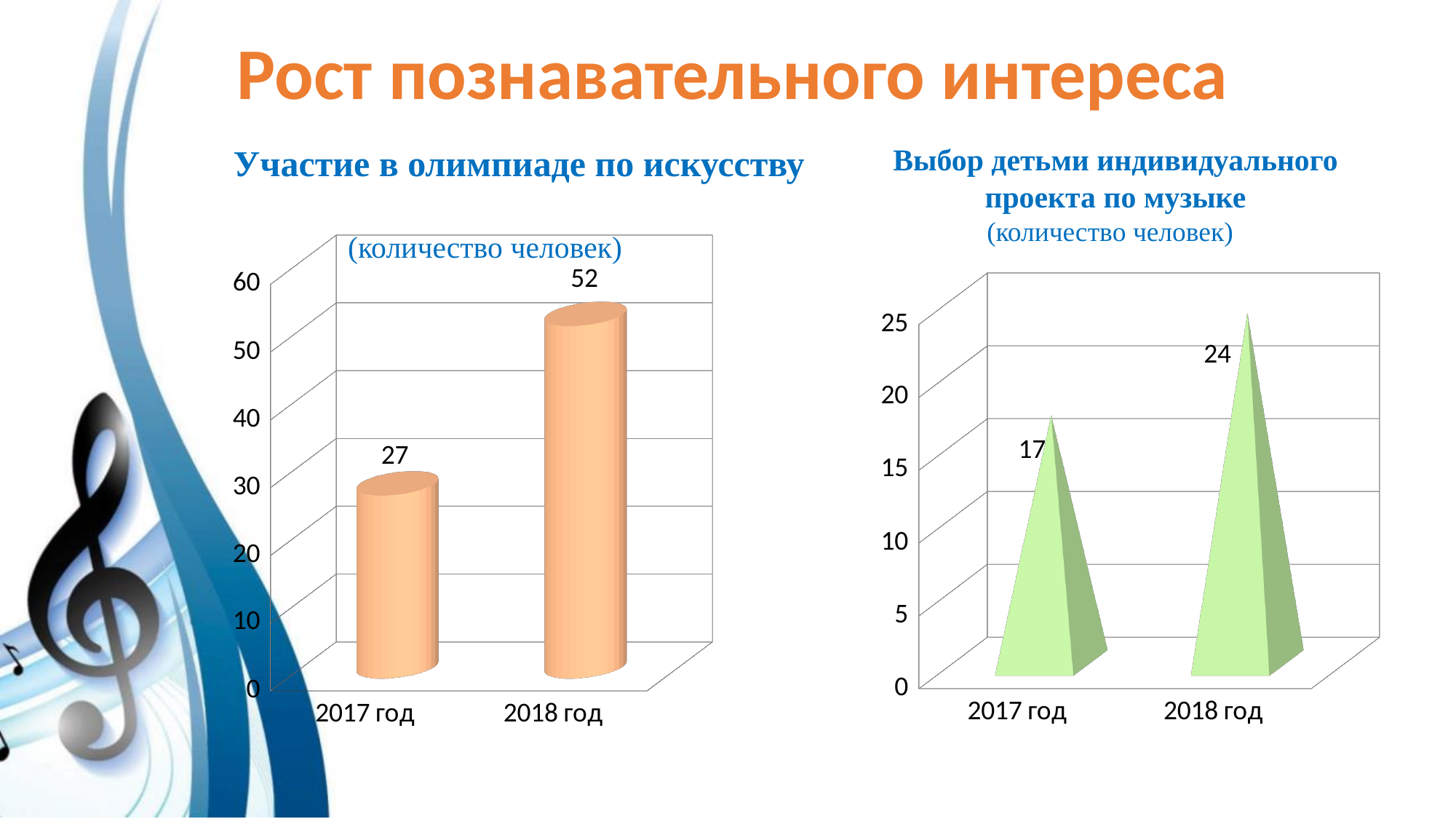
In the left chart (Участие в олимпиаде по искусству), what is the difference between the values for 2018 год and 2017 год? 25 In the right chart (Выбор детьми индивидуального проекта по музыке), what is the value for 2017 год? 17 In the right chart (Выбор детьми индивидуального проекта по музыке), what is the difference between the values for 2018 год and 2017 год? 7 In the right chart (Выбор детьми индивидуального проекта по музыке), do the values rise or fall from 2017 год to 2018 год? rise In the right chart (Выбор детьми индивидуального проекта по музыке), is the value for 2018 год greater or less than 20? greater In the left chart (Участие в олимпиаде по искусству), which year has the highest value? 2018 год In the left chart (Участие в олимпиаде по искусству), what is the value for 2017 год? 27 How many categories are shown on the x axis of the left chart (Участие в олимпиаде по искусству)? 2 In the right chart (Выбор детьми индивидуального проекта по музыке), which year has the lowest value? 2017 год In the right chart (Выбор детьми индивидуального проекта по музыке), what is the value for 2018 год? 24 What kind of chart is the left chart (Участие в олимпиаде по искусству)? bar chart In the left chart (Участие в олимпиаде по искусству), what is the value for 2018 год? 52